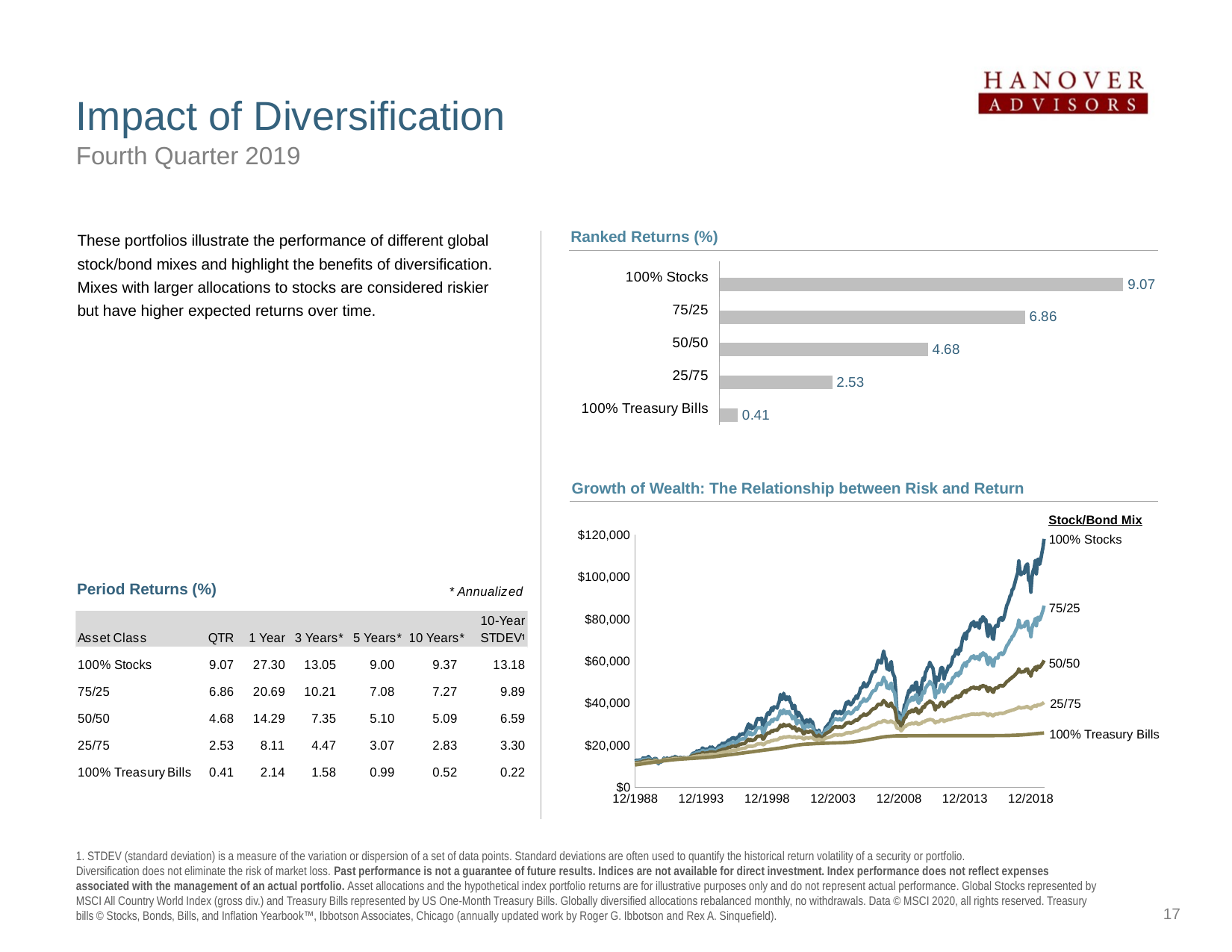
In the Ranked Returns (%) chart, which category has the highest value? 100% Stocks In the Ranked Returns (%) chart, which category has the lowest value? 100% Treasury Bills What kind of chart is the Growth of Wealth chart? Line chart In the Ranked Returns (%) chart, what is the value for 50/50? 4.68 What kind of chart is the Ranked Returns (%) chart? Bar chart In the Ranked Returns (%) chart, what is the difference between the values for 100% Stocks and 75/25? 2.21 In the Growth of Wealth chart, is the value of the 100% Treasury Bills line at 12/2018 greater or less than $40,000? less In the Ranked Returns (%) chart, what is the value for 100% Treasury Bills? 0.41 In the Ranked Returns (%) chart, what is the value for 100% Stocks? 9.07 In the Ranked Returns (%) chart, which is larger, the value for 25/75 or the value for 50/50? 50/50 How many stock/bond mixes are plotted in the Growth of Wealth chart? 5 How many categories are shown in the Ranked Returns (%) chart? 5